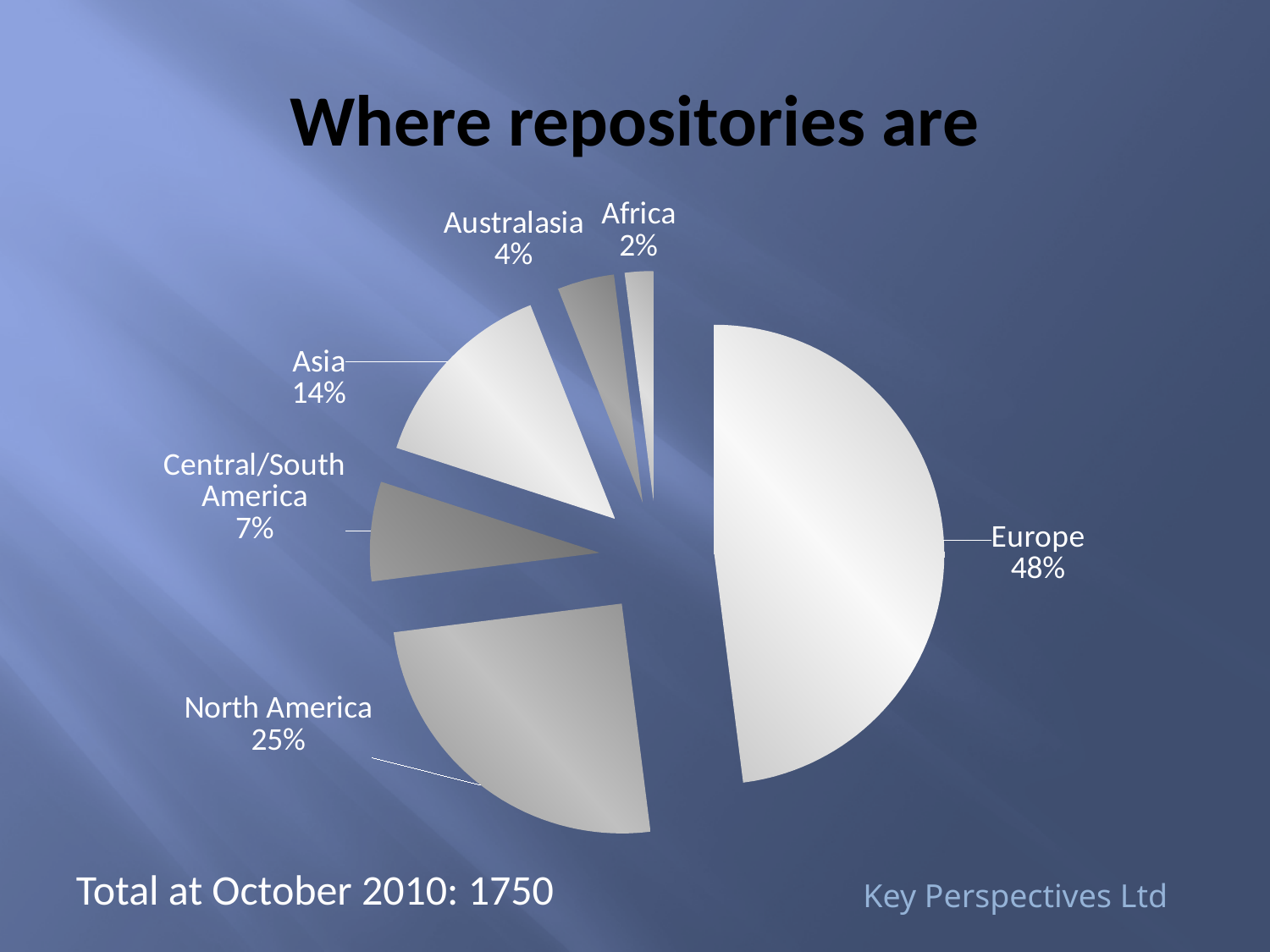
What share of repositories is in Africa? 2% What share of repositories is in North America? 25% Which region has the smallest share of repositories? Africa How many regions are shown in the pie chart? 6 Which region has the largest share of repositories? Europe What type of chart is shown on the slide? Pie chart What share of repositories is in Australasia? 4% Which has a larger share, Asia or Central/South America? Asia How many percentage points larger is Europe's share than North America's? 23